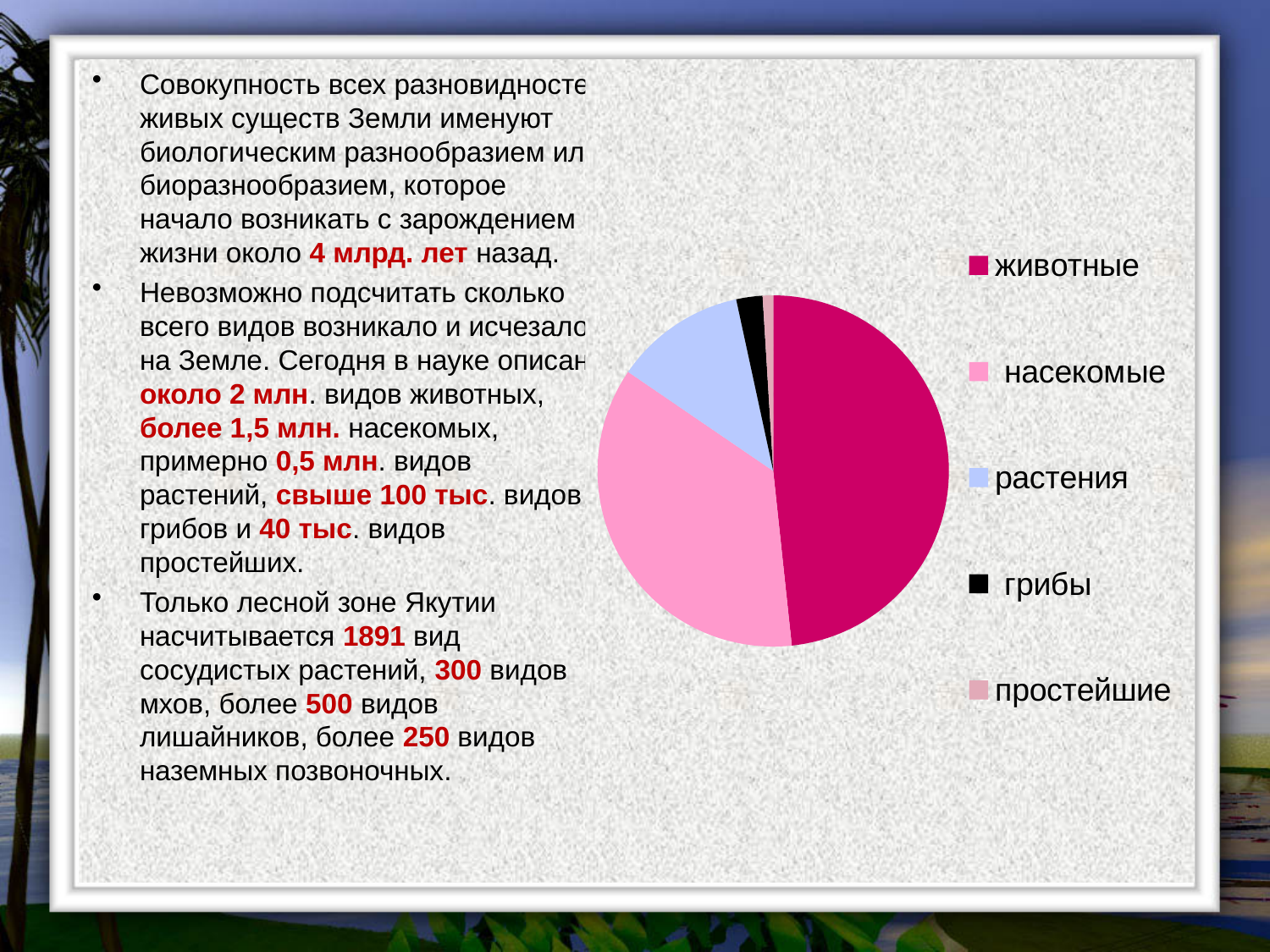
Which category has the smallest slice of the pie chart? простейшие What colour is the грибы slice in the pie chart? black Which category has the largest slice of the pie chart? животные Which slice is larger in the pie chart, растения or грибы? растения Which slice is larger in the pie chart, животные or насекомые? животные Which slice is larger in the pie chart, насекомые or растения? насекомые How many entries does the legend of the pie chart list? 5 How many categories does the pie chart show? 5 Which legend entry is listed first in the pie chart's legend? животные What kind of chart is shown on the slide? pie chart